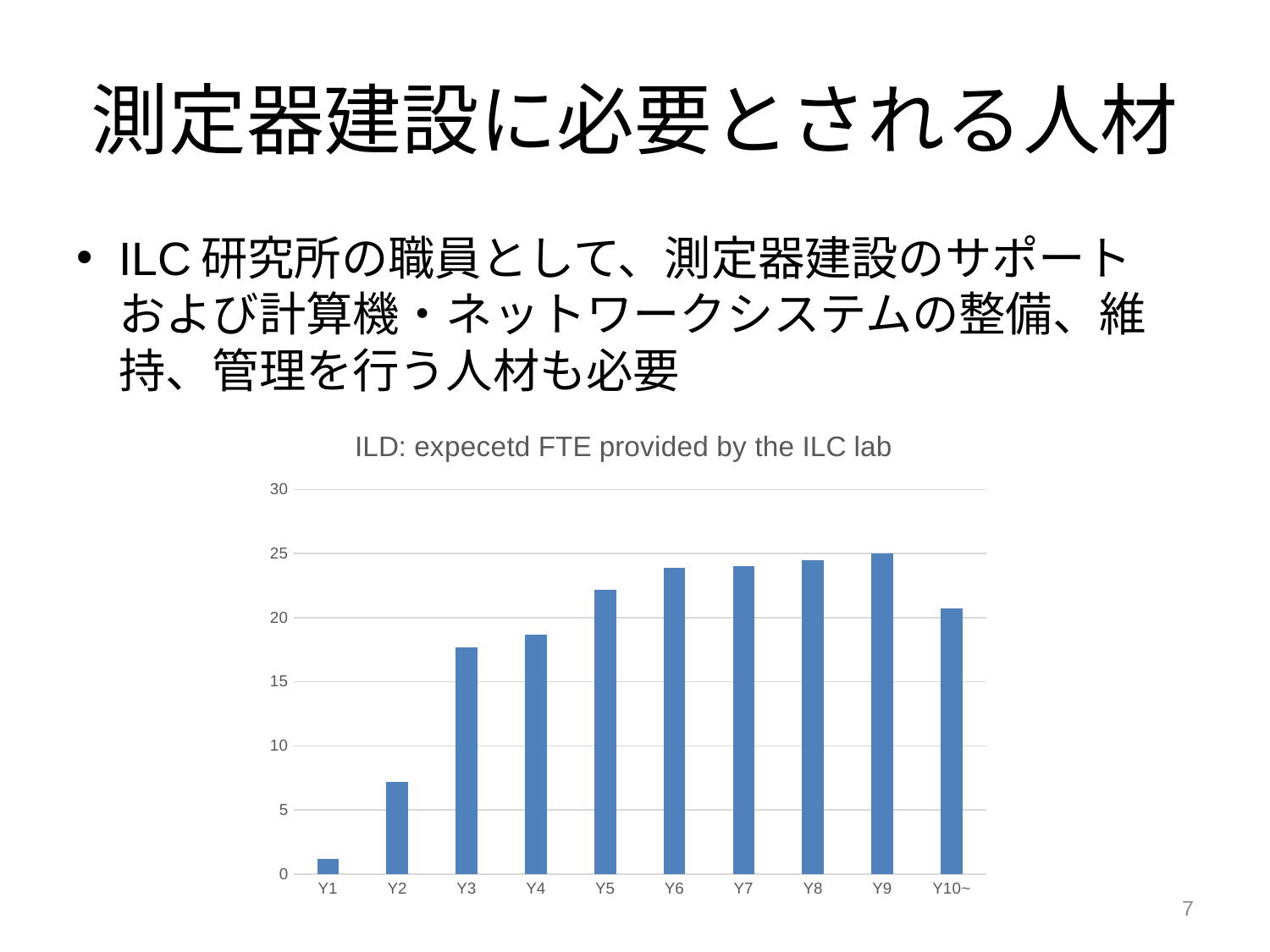
Is the value for Y4 greater or less than 20? less Is the value for Y3 greater or less than 15? greater What is the title of the chart? ILD: expecetd FTE provided by the ILC lab What is the value for Y9 in the chart? 25 Is the value for Y1 greater or less than 5? less Do the values rise or fall from Y1 to Y9? rise How many categories (years) are shown on the x axis of the chart? 10 Which is larger, the value for Y3 or the value for Y10~? Y10~ Which category has the lowest value in the chart? Y1 What kind of chart is shown on the slide? bar chart